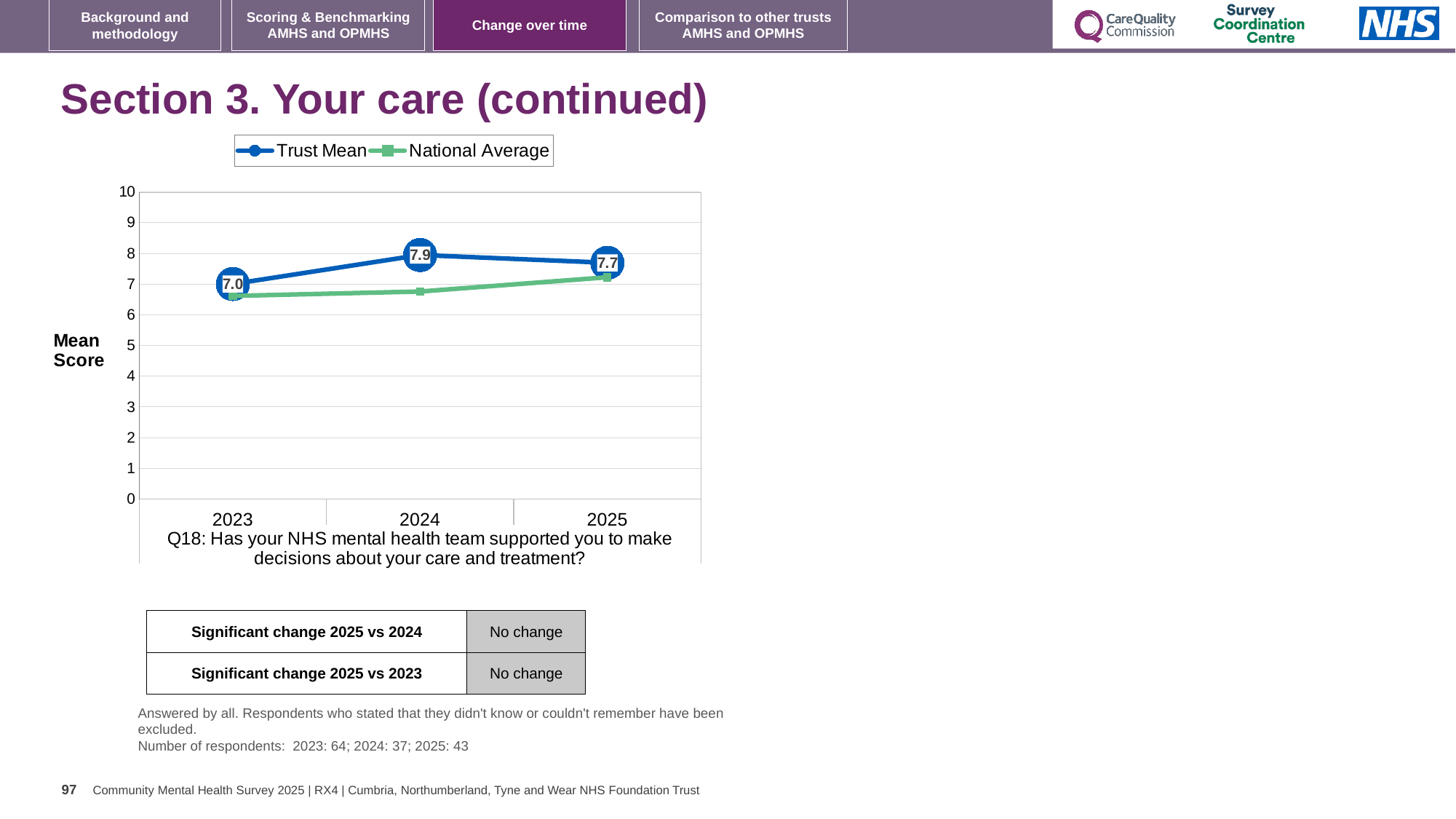
Does the National Average rise or fall from 2023 to 2025? Rises What is the Trust Mean score for 2023? 7.0 In which year is the Trust Mean highest? 2024 Is the National Average value for 2023 greater or less than 7? less By how much did the Trust Mean increase from 2023 to 2024? 0.9 How many years are plotted on the x axis? 3 What is the Trust Mean score for 2024? 7.9 How many series does the legend list? 2 What kind of chart is shown on the slide? Line chart In which year is the Trust Mean lowest? 2023 What is the Trust Mean score for 2025? 7.7 Which is larger, the Trust Mean in 2024 or in 2025? 2024